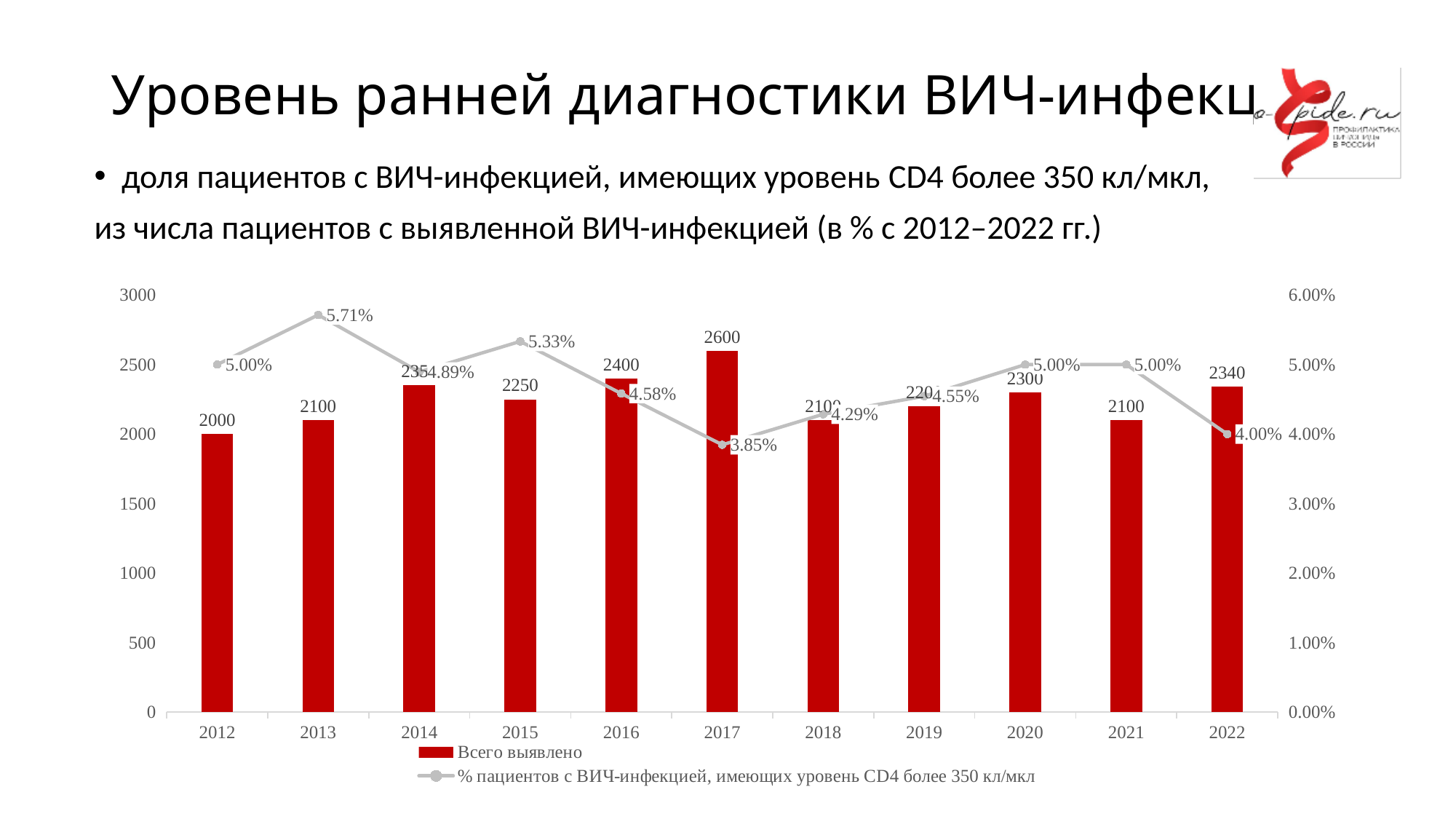
What percentage of patients with CD4 above 350 кл/мкл is shown for 2017? 3.85% How many years are shown on the x axis? 11 How many series does the legend list? 2 What is the value of "Всего выявлено" for 2017? 2600 Which is larger, "Всего выявлено" in 2016 or in 2021? 2016 Which year has the highest value of "Всего выявлено"? 2017 What percentage of patients with CD4 above 350 кл/мкл is shown for 2013? 5.71% What colour are the bars for "Всего выявлено"? Red What is the value of "Всего выявлено" for 2012? 2000 What is the difference between "Всего выявлено" in 2017 and in 2012? 600 Which year has the lowest percentage of patients with CD4 above 350 кл/мкл? 2017 What is the value of "Всего выявлено" for 2022? 2340